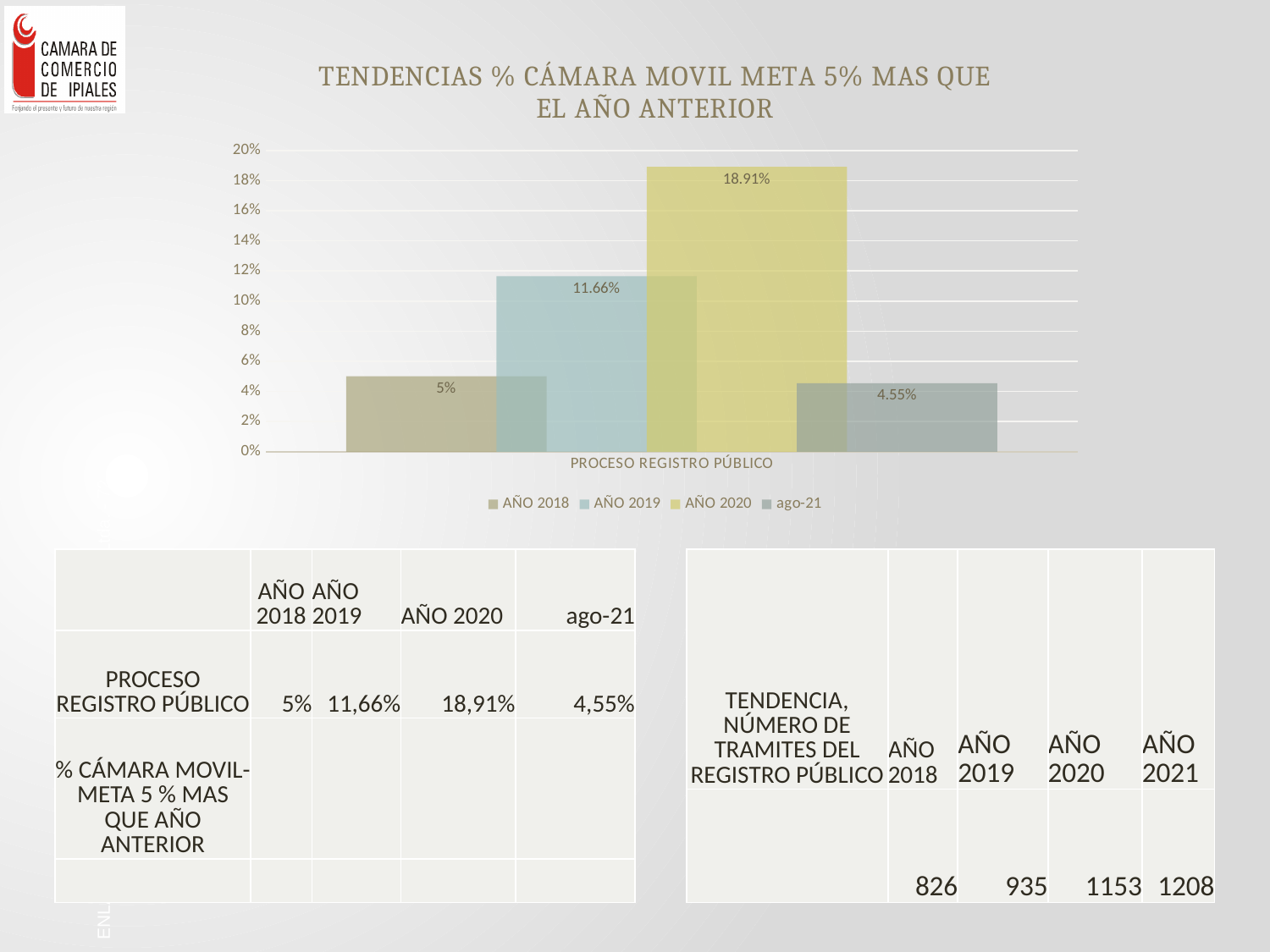
Which is larger, the value for AÑO 2018 or the value for ago-21? AÑO 2018 What is the value for AÑO 2020 in the chart? 18.91% What kind of chart is shown on the slide? bar chart What is the difference between the AÑO 2020 value and the AÑO 2019 value? 7.25% What is the category label shown on the x axis of the chart? PROCESO REGISTRO PÚBLICO How many series does the legend list? 4 What is the value for AÑO 2019 in the chart? 11.66% What is the value for AÑO 2018 in the chart? 5% What is the value for ago-21 in the chart? 4.55% Is the value for AÑO 2019 greater or less than 10%? greater Which series has the lowest value in the chart? ago-21 Which series has the highest value in the chart? AÑO 2020